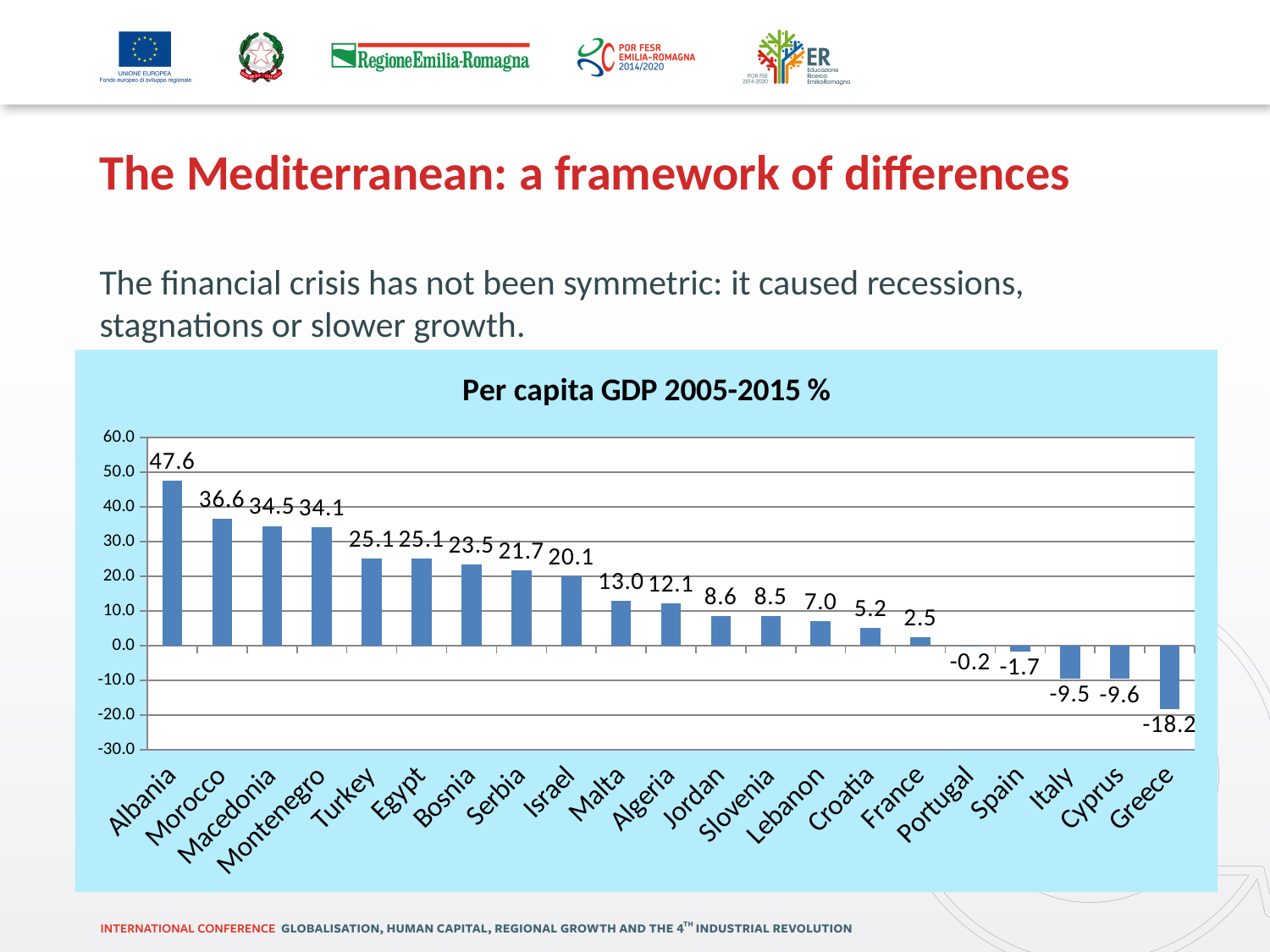
Which has a larger value, Malta or Algeria? Malta What is the difference between the values for Morocco and Montenegro? 2.5 What is the value shown for Greece? -18.2 What is the title of the chart? Per capita GDP 2005-2015 % Which country has the lowest per capita GDP 2005-2015 % value? Greece What is the value shown for Serbia? 21.7 Is the value for Turkey greater or less than 20.0? greater What is the per capita GDP 2005-2015 % value for Albania? 47.6 What kind of chart is shown on the slide? Bar chart Which country has the highest per capita GDP 2005-2015 % value? Albania How many countries are shown in the chart? 21 Do the values rise or fall moving from left to right along the x axis? Fall